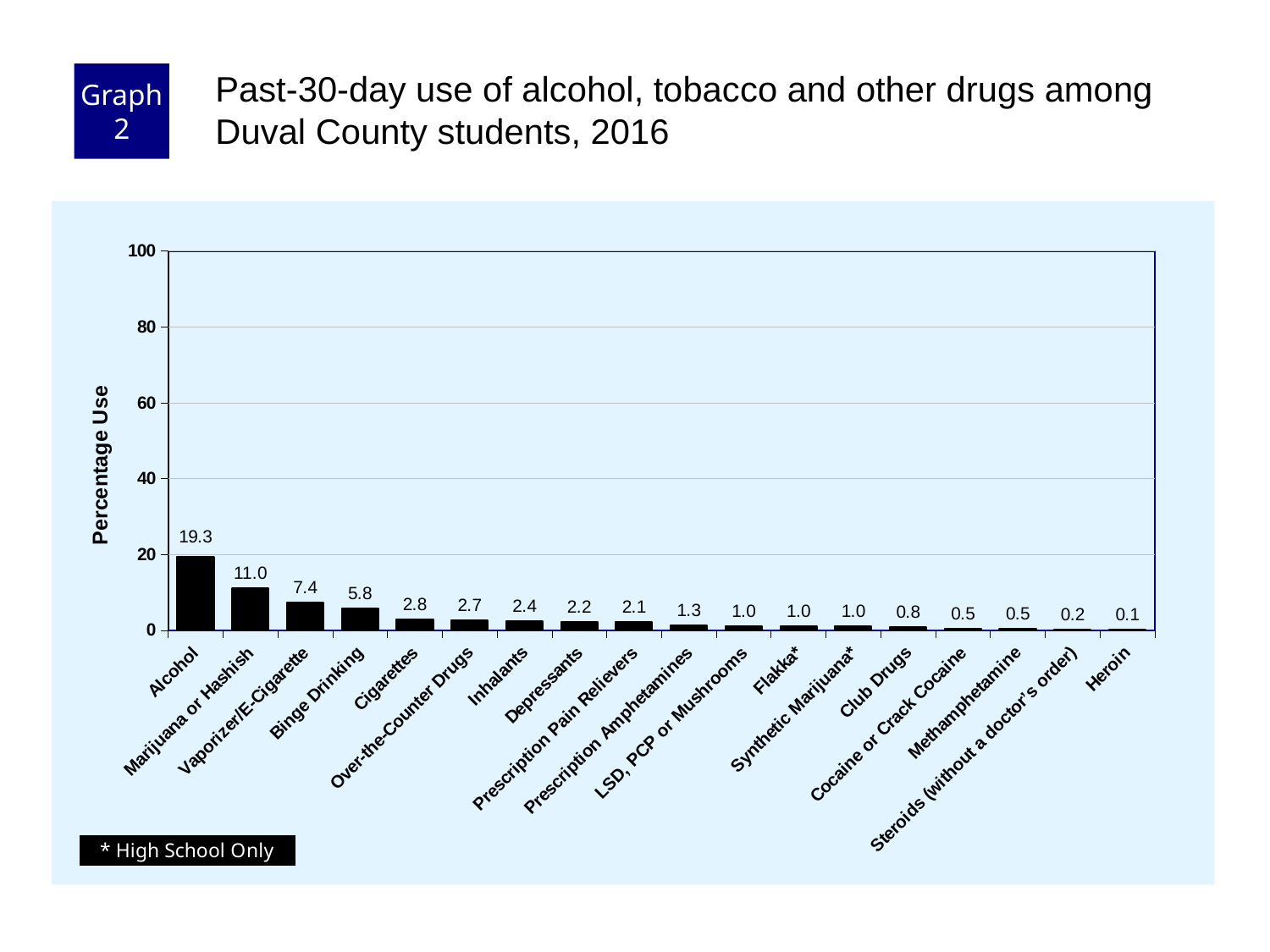
What is the value for Alcohol? 19.3 Which category has the lowest value? Heroin Which is larger, the value for Cigarettes or the value for Depressants? Cigarettes What is the difference between the values for Binge Drinking and Cigarettes? 3.0 What is the value for Inhalants? 2.4 What is the difference between the values for Alcohol and Marijuana or Hashish? 8.3 What is the value for Club Drugs? 0.8 What is the value for Vaporizer/E-Cigarette? 7.4 What kind of chart is this? bar chart Is the value for Marijuana or Hashish greater or less than 20? less How many categories are shown on the x axis? 18 Which category has the highest value? Alcohol